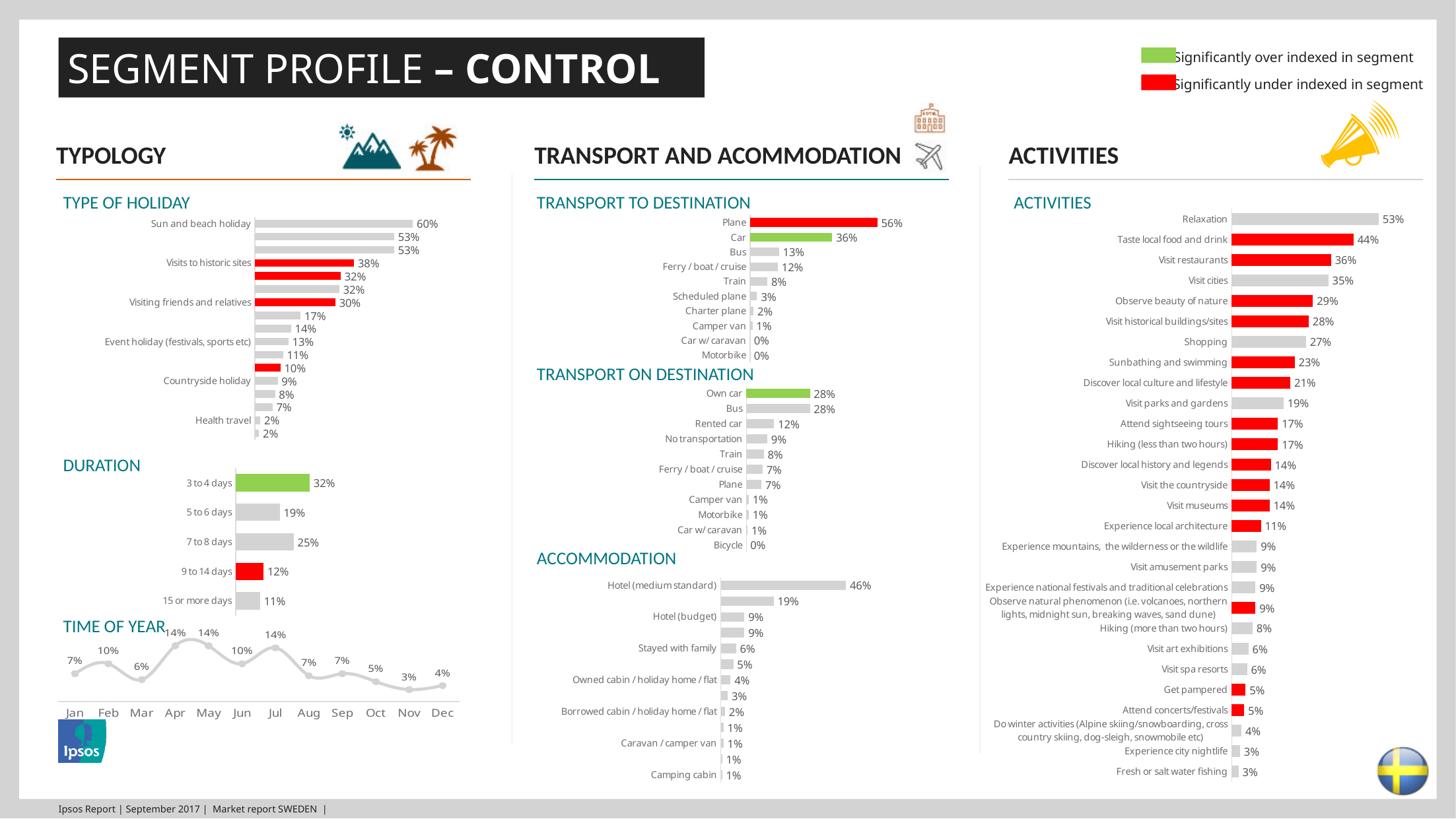
In the Time of Year chart, which month has the lowest value? Nov How many categories does the Duration chart show? 5 In the Transport to Destination chart, what is the value for Car? 36% In the Duration chart, which category has the highest value? 3 to 4 days In the Type of Holiday chart, what is the difference between Visits to historic sites and Visiting friends and relatives? 8% In the Transport on Destination chart, what is the value for Rented car? 12% In the Transport to Destination chart, which is larger, Bus or Ferry / boat / cruise? Bus In the Type of Holiday chart, what is the value for Sun and beach holiday? 60% What kind of chart is the Time of Year chart? line chart In the Accommodation chart, what is the value for Hotel (medium standard)? 46% In the Duration chart, what is the value for 7 to 8 days? 25% In the Activities chart, what is the difference between Relaxation and Taste local food and drink? 9%